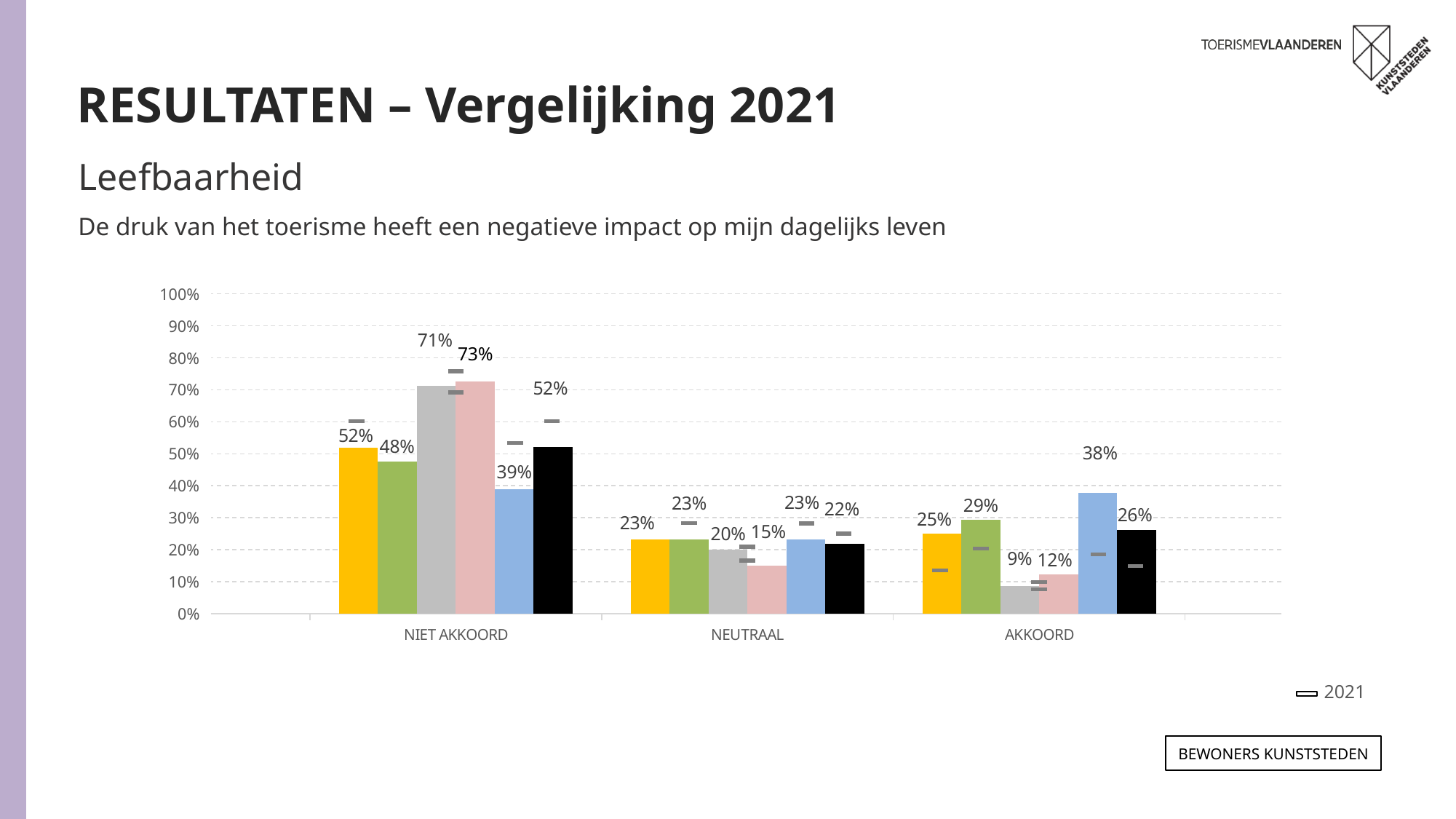
What is the value of the grey bar for NEUTRAAL? 20% What kind of chart is shown on the slide? bar chart What is the value of the black bar for AKKOORD? 26% What is the only entry shown in the chart legend? 2021 How many categories are shown on the x axis? 3 Which bar has the highest value in the NIET AKKOORD group? the pink bar (73%) Which bar has the lowest value in the AKKOORD group? the grey bar (9%) Is the value of the pink bar for NEUTRAAL greater or less than 20%? less What is the value of the blue bar for AKKOORD? 38% What is the difference between the grey bar and the blue bar for NIET AKKOORD? 32% What is the value of the pink bar for NIET AKKOORD? 73% Which is larger for AKKOORD: the green bar or the yellow bar? the green bar (29%)